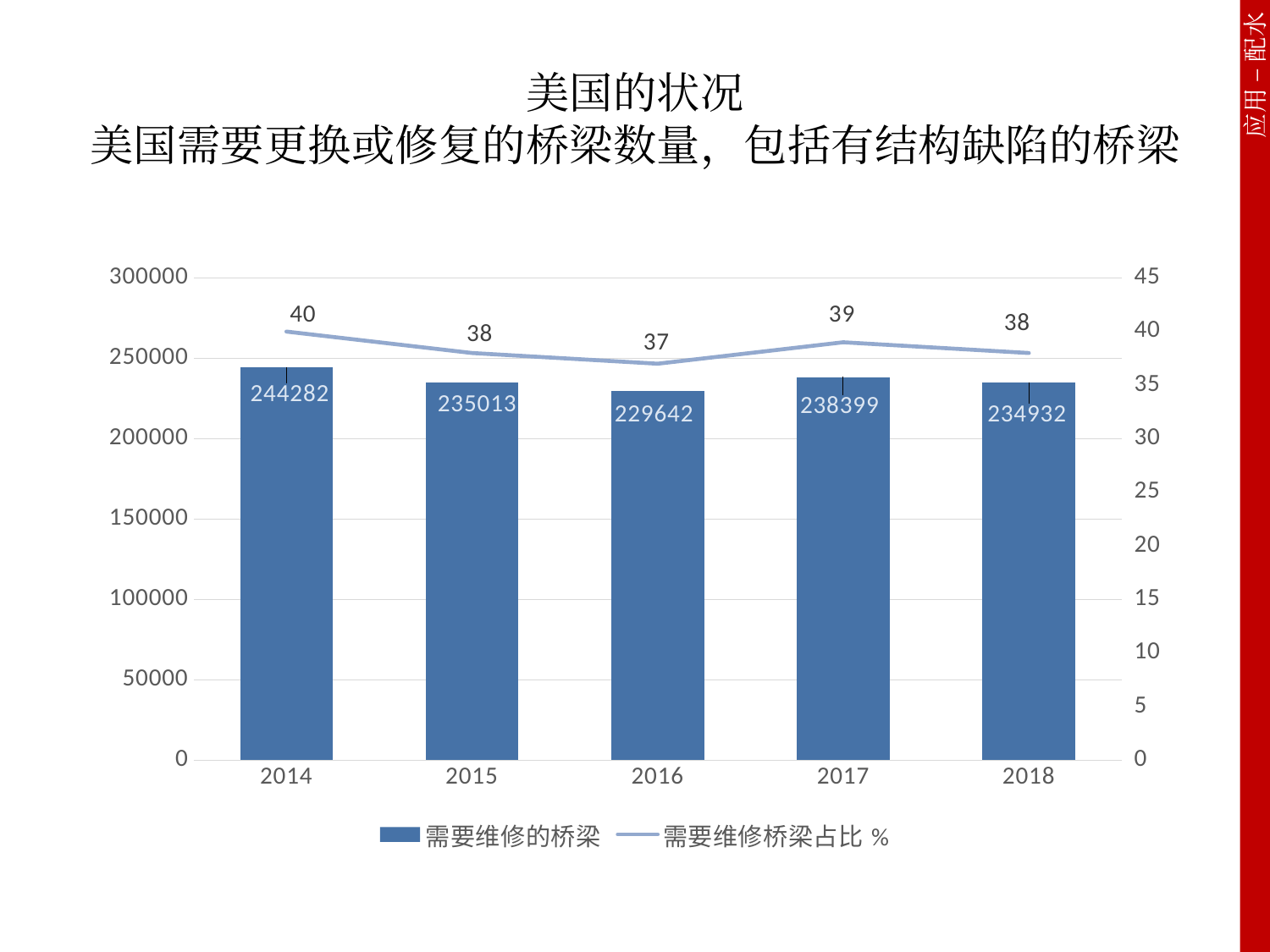
Does the 需要维修的桥梁 value rise or fall from 2014 to 2016? fall What is the value of 需要维修桥梁占比 % for 2014? 40 Which is larger, the 需要维修的桥梁 value for 2017 or for 2018? 2017 What is the value of 需要维修桥梁占比 % for 2017? 39 Which year has the highest value for 需要维修的桥梁? 2014 How many series does the legend list? 2 What is the value of 需要维修的桥梁 for 2016? 229642 Which year has the lowest value for 需要维修桥梁占比 %? 2016 What is the difference between the 需要维修的桥梁 values for 2014 and 2016? 14640 What kind of chart is used for the 需要维修的桥梁 series? bar chart What is the value of 需要维修的桥梁 for 2014? 244282 How many years are shown on the x axis? 5